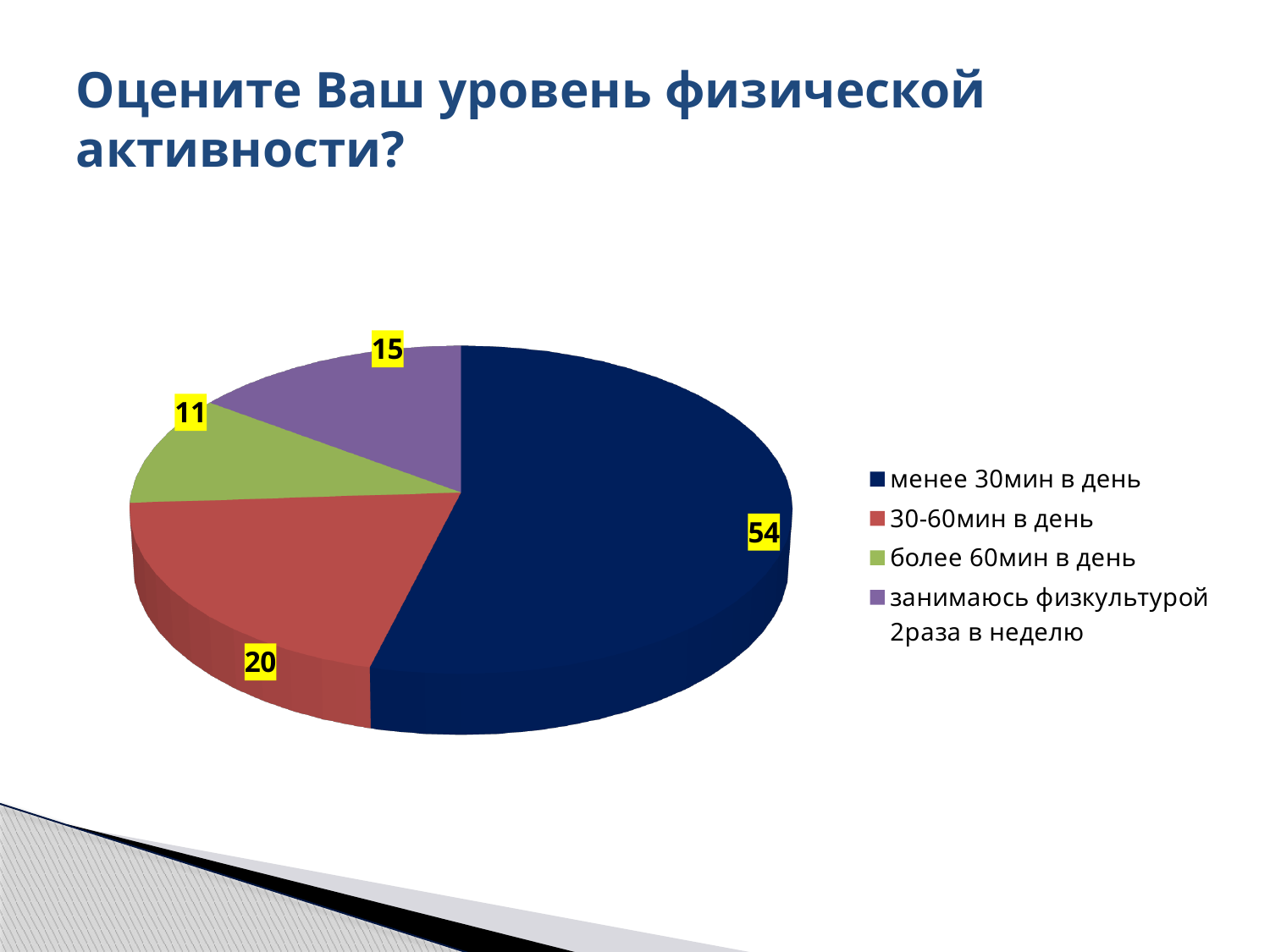
What is the value for "более 60мин в день"? 11 What is the total of all the slice values in the pie chart? 100 What is the value for "занимаюсь физкультурой 2раза в неделю"? 15 Which category has the smallest slice of the pie? более 60мин в день What is the value for "30-60мин в день"? 20 Which is larger: the value for "занимаюсь физкультурой 2раза в неделю" or the value for "более 60мин в день"? занимаюсь физкультурой 2раза в неделю How many slices does the pie chart have? 4 What colour is the slice for "30-60мин в день"? red What is the difference between the values for "менее 30мин в день" and "30-60мин в день"? 34 What kind of chart is shown on the slide? pie chart What is the value for "менее 30мин в день"? 54 Which category has the largest slice of the pie? менее 30мин в день